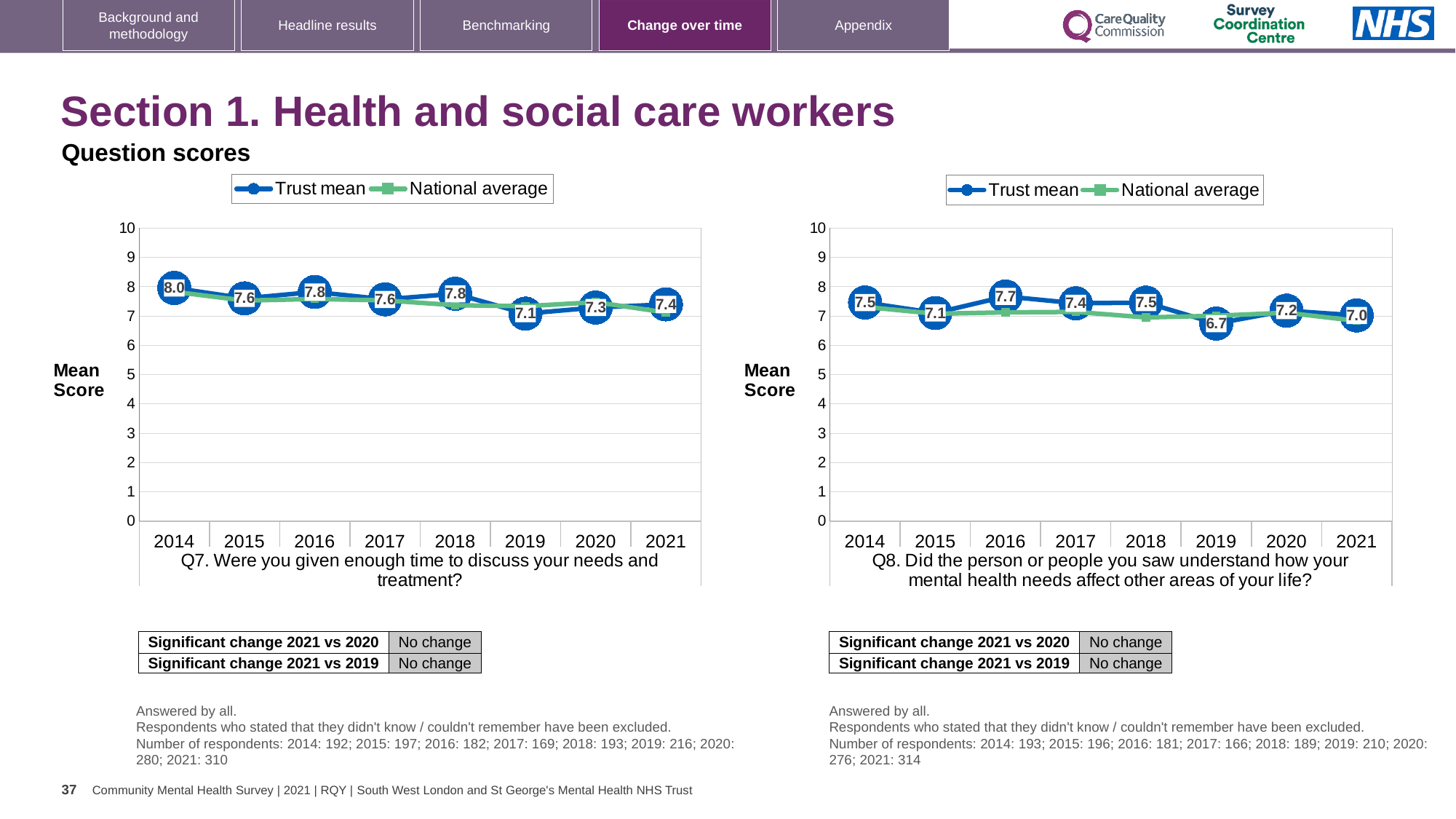
How many series does the legend of the Q7 chart (left) list? 2 In the Q8 chart (right), is the Trust mean score higher in 2020 or 2021? 2020 In the Q7 chart (left), what is the Trust mean score for 2021? 7.4 In the Q8 chart (right), what is the difference between the Trust mean scores for 2016 and 2021? 0.7 In the Q7 chart (left), what is the Trust mean score for 2014? 8.0 In the Q7 chart (left), what is the difference between the Trust mean scores for 2014 and 2019? 0.9 How many years are plotted on the x axis of the Q8 chart (right)? 8 In the Q8 chart (right), what is the Trust mean score for 2019? 6.7 In the Q8 chart (right), which year has the highest Trust mean score? 2016 What type of chart is the Q7 chart (left)? Line chart In the Q7 chart (left), which year has the highest Trust mean score? 2014 In the Q7 chart (left), which year has the lowest Trust mean score? 2019